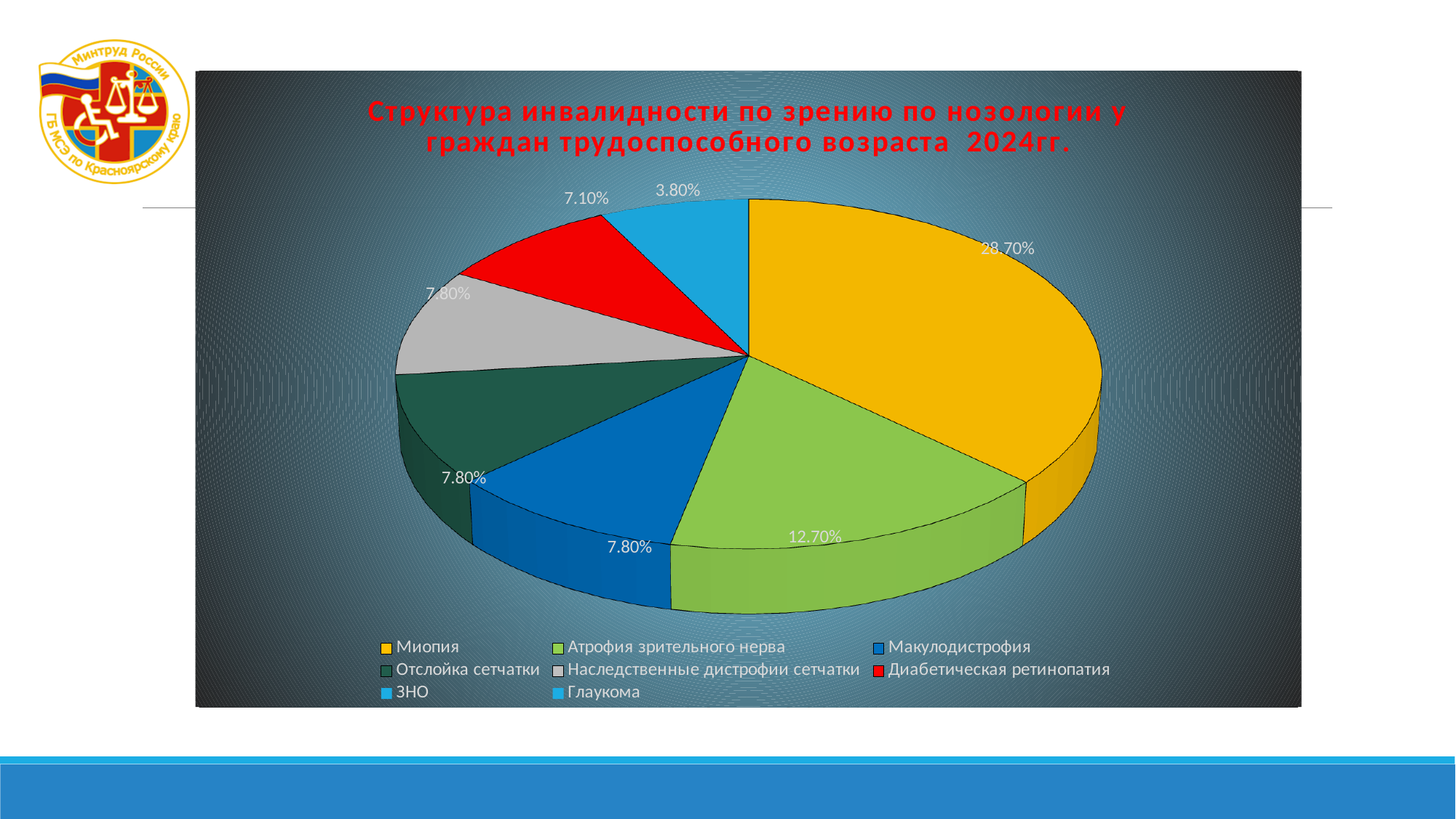
What percentage is shown for Миопия? 28.70% What percentage is shown for Макулодистрофия? 7.80% What is the difference in percentage points between Атрофия зрительного нерва and Диабетическая ретинопатия? 5.60% Which is larger, the share for Атрофия зрительного нерва or for Диабетическая ретинопатия? Атрофия зрительного нерва What colour represents Миопия in the pie chart? Yellow How many entries does the legend list? 8 What percentage is shown for Диабетическая ретинопатия? 7.10% Which category has the largest share of the pie? Миопия What is the difference in percentage points between Миопия and Атрофия зрительного нерва? 16.00% What percentage is shown for Атрофия зрительного нерва? 12.70% What type of chart is shown on the slide? Pie chart What is the smallest percentage label shown on the pie? 3.80%